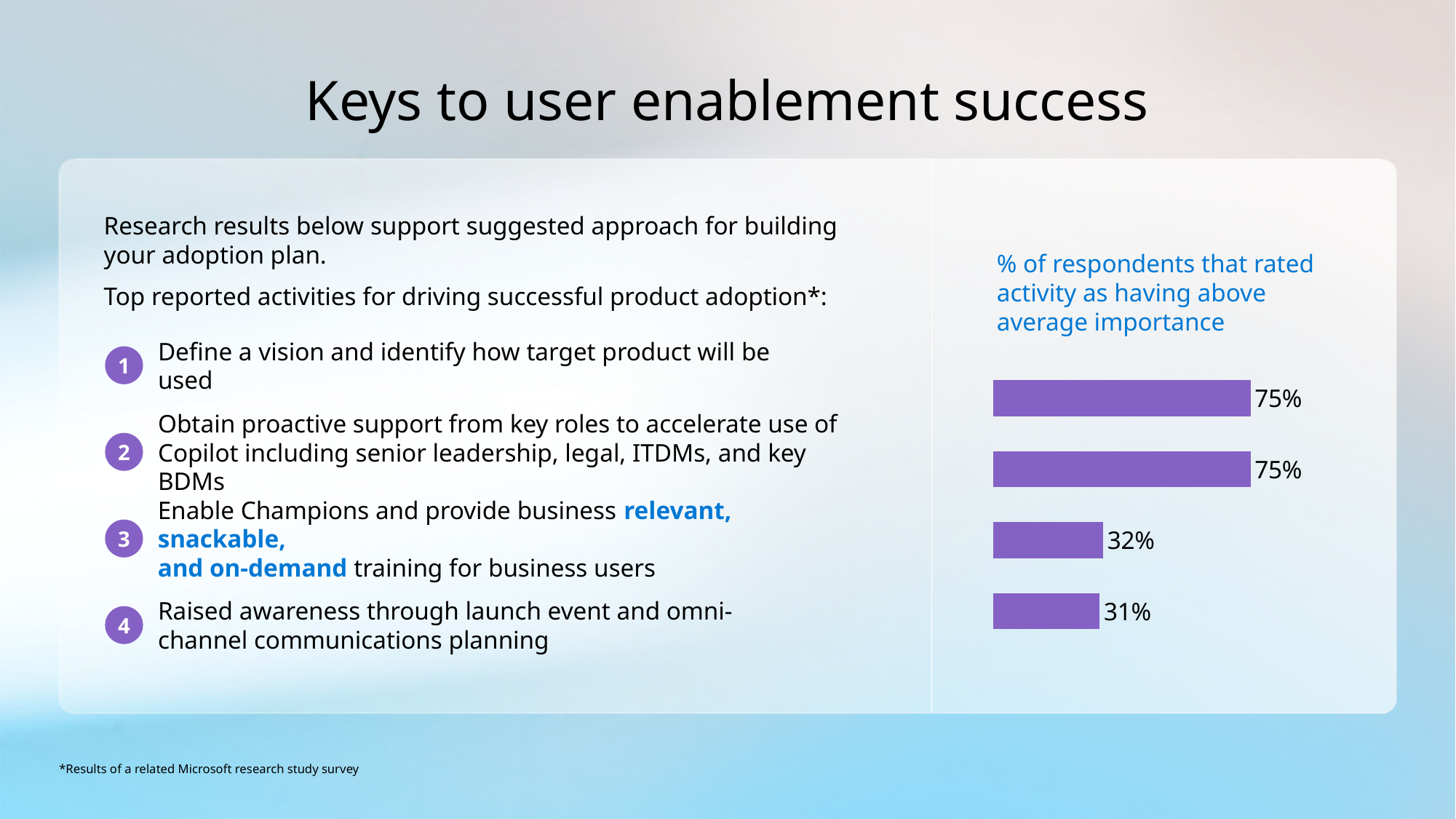
What is the value shown for the bottom bar in the chart? 31% What is the difference between the third bar's value and the bottom bar's value in the chart? 1% What is the difference between the top bar's value and the bottom bar's value in the chart? 44% What is the value shown for the second bar from the top in the chart? 75% Do the bar values rise or fall going from the top bar to the bottom bar of the chart? fall What is the title of the chart on the right side of the slide? % of respondents that rated activity as having above average importance What type of chart is shown on the right side of the slide? bar chart Which is larger in the chart: the value of the second bar from the top or the value of the third bar from the top? the second bar from the top (75%) How many bars does the chart on the right show? 4 What is the value shown for the third bar from the top in the chart? 32% Which bar in the chart has the lowest value? the bottom bar (31%) What is the value shown for the top bar in the chart? 75%